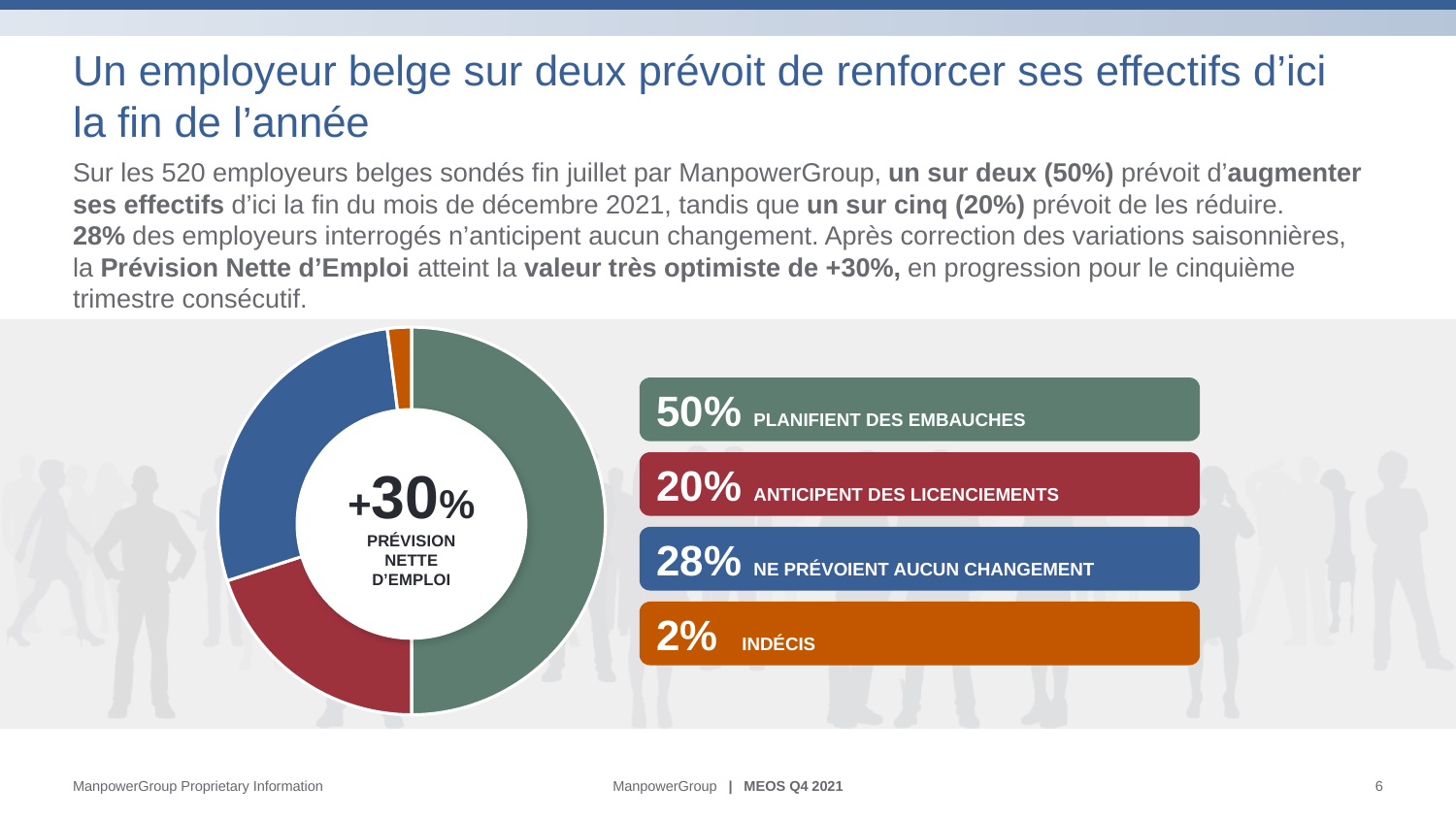
What percentage of employers plan to hire (planifient des embauches)? 50% What value is displayed in the centre of the donut chart? +30% Which category has the largest share of the donut chart? Planifient des embauches What percentage of employers foresee no change (ne prévoient aucun changement)? 28% Which category has the smallest share of the donut chart? Indécis What kind of chart is shown on the slide? Donut (pie) chart What percentage of employers are undecided (indécis)? 2% How many categories are shown in the donut chart? 4 What colour represents the 'Indécis' category in the donut chart? Orange What is the difference in percentage points between employers who plan to hire and those who anticipate layoffs? 30 percentage points Which is larger: the share of employers who foresee no change or the share who anticipate layoffs? Ne prévoient aucun changement (28%) What percentage of employers anticipate layoffs (anticipent des licenciements)? 20%